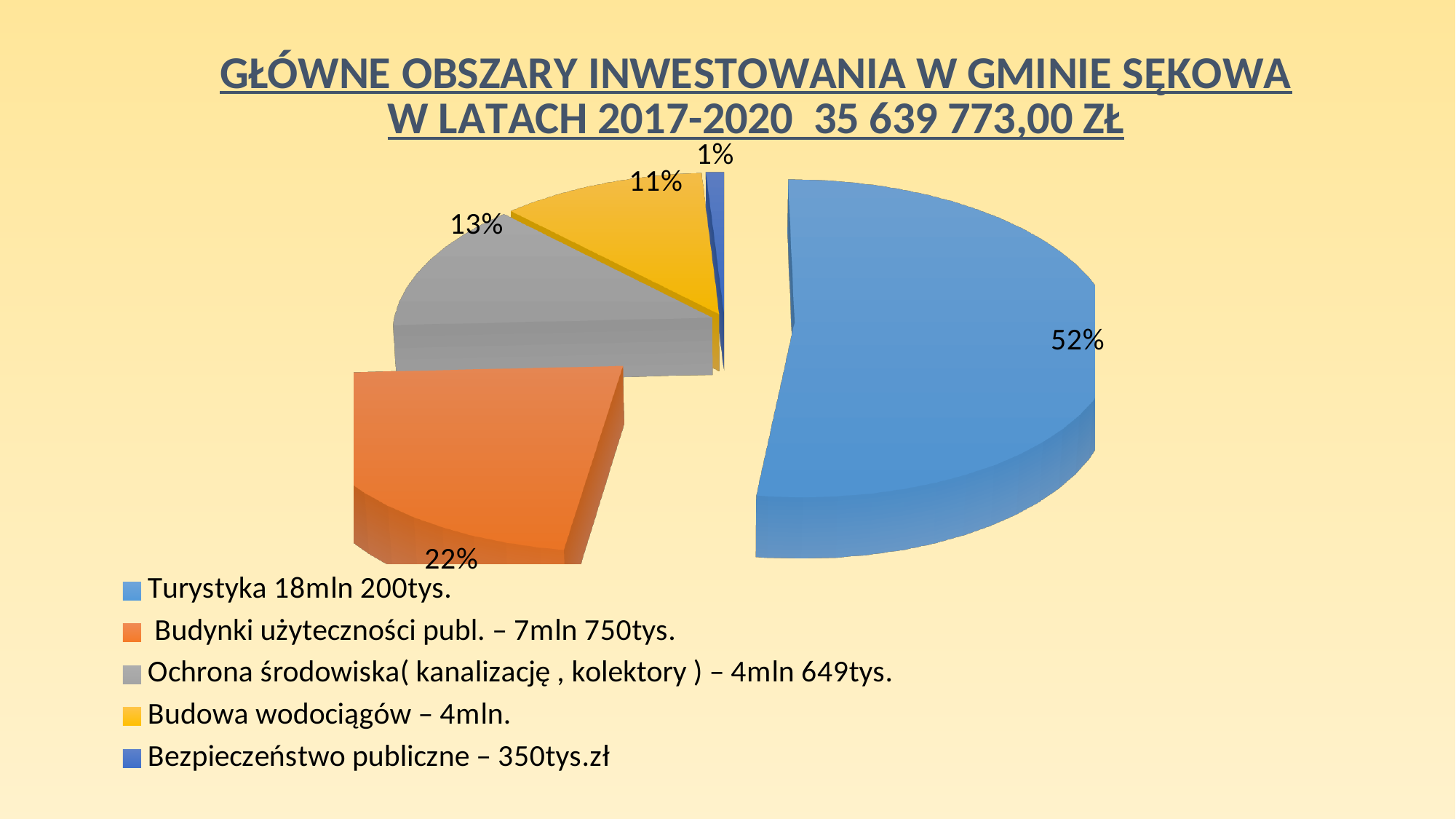
What is the difference in percentage points between the Turystyka slice and the Budynki użyteczności publ. slice? 30 What share of the pie does Ochrona środowiska (kanalizację, kolektory) represent? 13% What share of the pie does Budynki użyteczności publ. represent? 22% What colour is the Turystyka slice in the pie chart? blue Which category has the largest slice of the pie? Turystyka What share of the pie does Bezpieczeństwo publiczne represent? 1% How many slices does the pie chart have? 5 Which category has the smallest slice of the pie? Bezpieczeństwo publiczne Which slice is larger: Ochrona środowiska or Budowa wodociągów? Ochrona środowiska What kind of chart is shown on the slide? pie chart